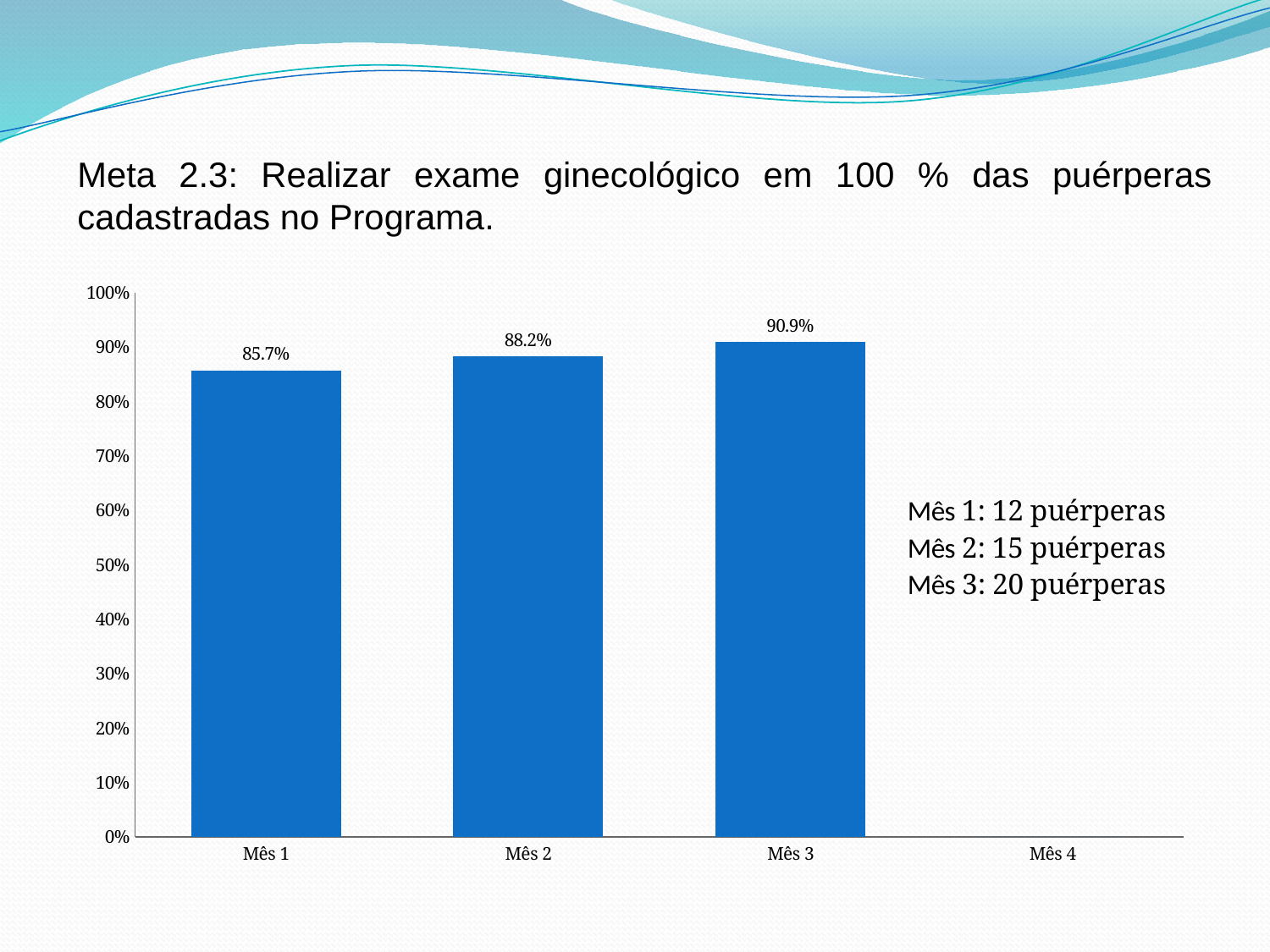
Which is larger, the value for Mês 2 or the value for Mês 3? Mês 3 How many bars are plotted on the chart? 3 Do the values rise or fall from Mês 1 to Mês 3? rise What kind of chart is shown on the slide? bar chart What is the difference between the values for Mês 3 and Mês 1? 5.2% Is the value for Mês 1 greater or less than 90%? less Which month with a plotted bar has the lowest value? Mês 1 What is the value for Mês 1? 85.7% What is the value for Mês 3? 90.9% What is the value for Mês 2? 88.2% What is the difference between the values for Mês 2 and Mês 1? 2.5% Which month has the highest value? Mês 3